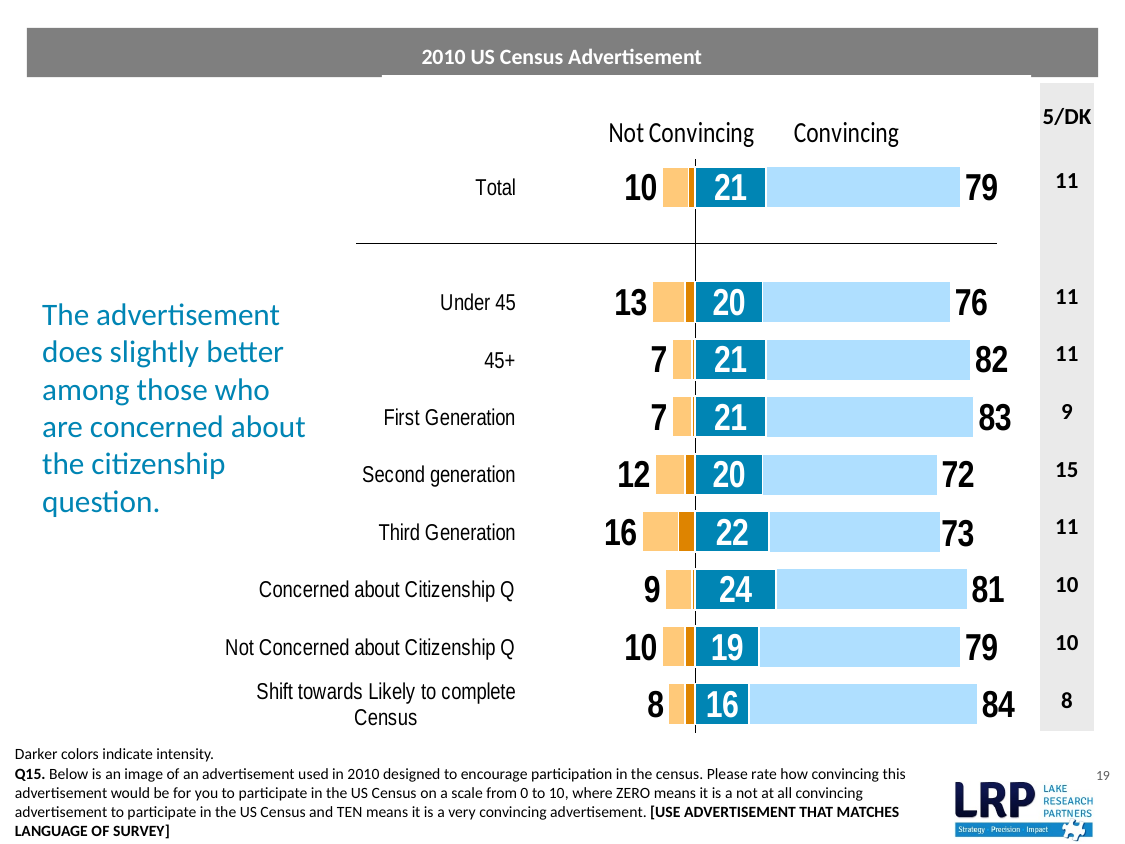
What is the 5/DK value for Second generation? 15 Which has a larger Convincing value, Under 45 or 45+? 45+ What kind of chart is shown on the slide? Stacked bar chart What is the Not Convincing value for Third Generation? 16 Which category has the highest Convincing value? Shift towards Likely to complete Census How many categories (rows) are shown in the chart? 9 What is the Convincing value for Total? 79 What is the difference between the Convincing values for Concerned about Citizenship Q and Not Concerned about Citizenship Q? 2 What is the value printed in the dark blue segment for Concerned about Citizenship Q? 24 Which category has the lowest Convincing value? Second generation What is the title of the chart? 2010 US Census Advertisement Which category has the highest Not Convincing value? Third Generation